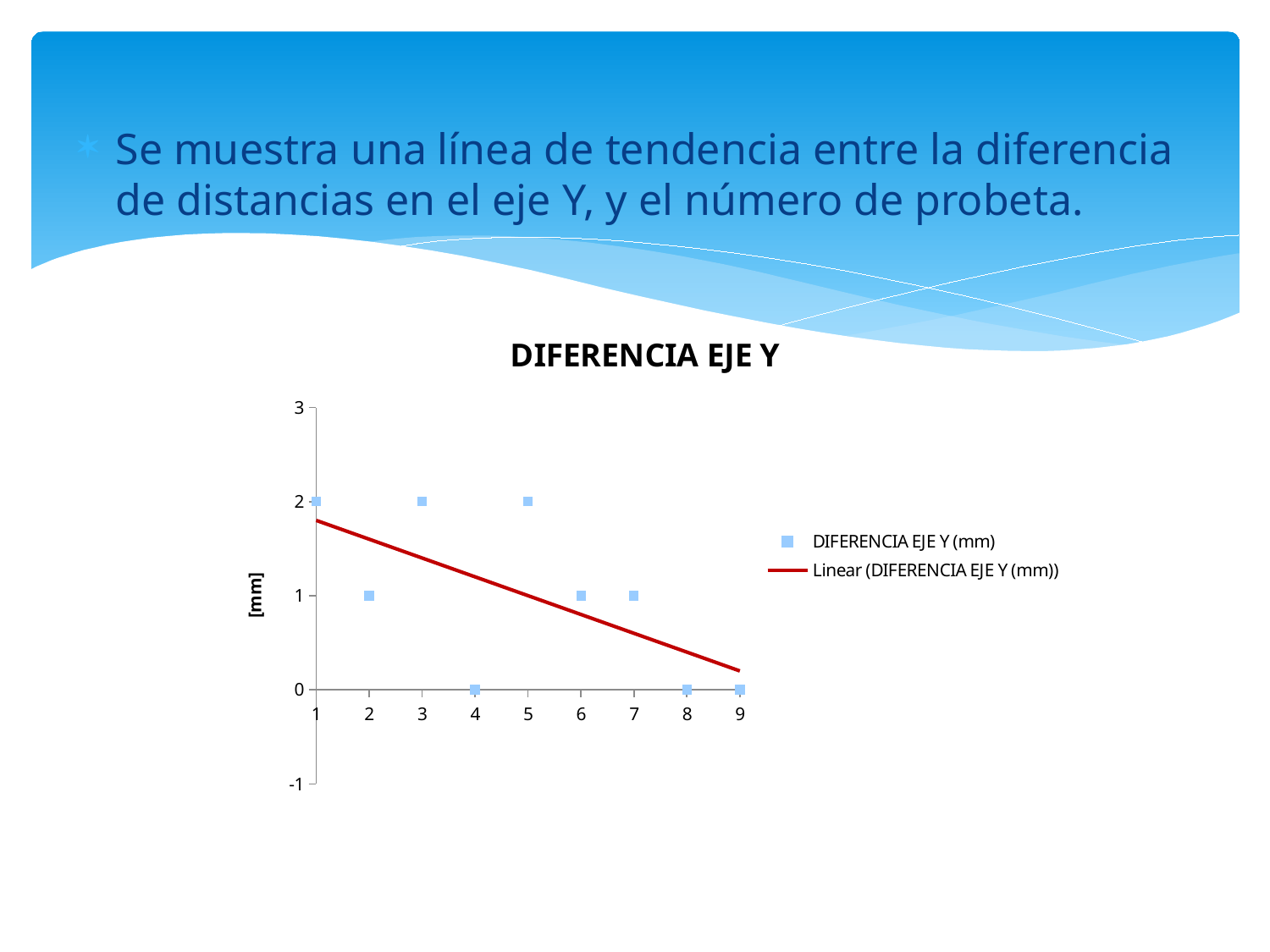
Does the linear trendline in the DIFERENCIA EJE Y chart rise or fall from probeta 1 to probeta 9? fall What kind of chart is shown on the slide? scatter chart with a linear trendline What is the lowest value plotted in the DIFERENCIA EJE Y chart? 0 What is the value for probeta 1 in the DIFERENCIA EJE Y chart? 2 How many data points are plotted in the DIFERENCIA EJE Y chart? 9 What is the highest value plotted in the DIFERENCIA EJE Y chart? 2 What is the value for probeta 6 in the DIFERENCIA EJE Y chart? 1 Which has a larger value, probeta 5 or probeta 7? probeta 5 How many entries does the legend of the DIFERENCIA EJE Y chart list? 2 What is the value for probeta 4 in the DIFERENCIA EJE Y chart? 0 What is the difference between the values for probeta 3 and probeta 2? 1 What is the value for probeta 9 in the DIFERENCIA EJE Y chart? 0